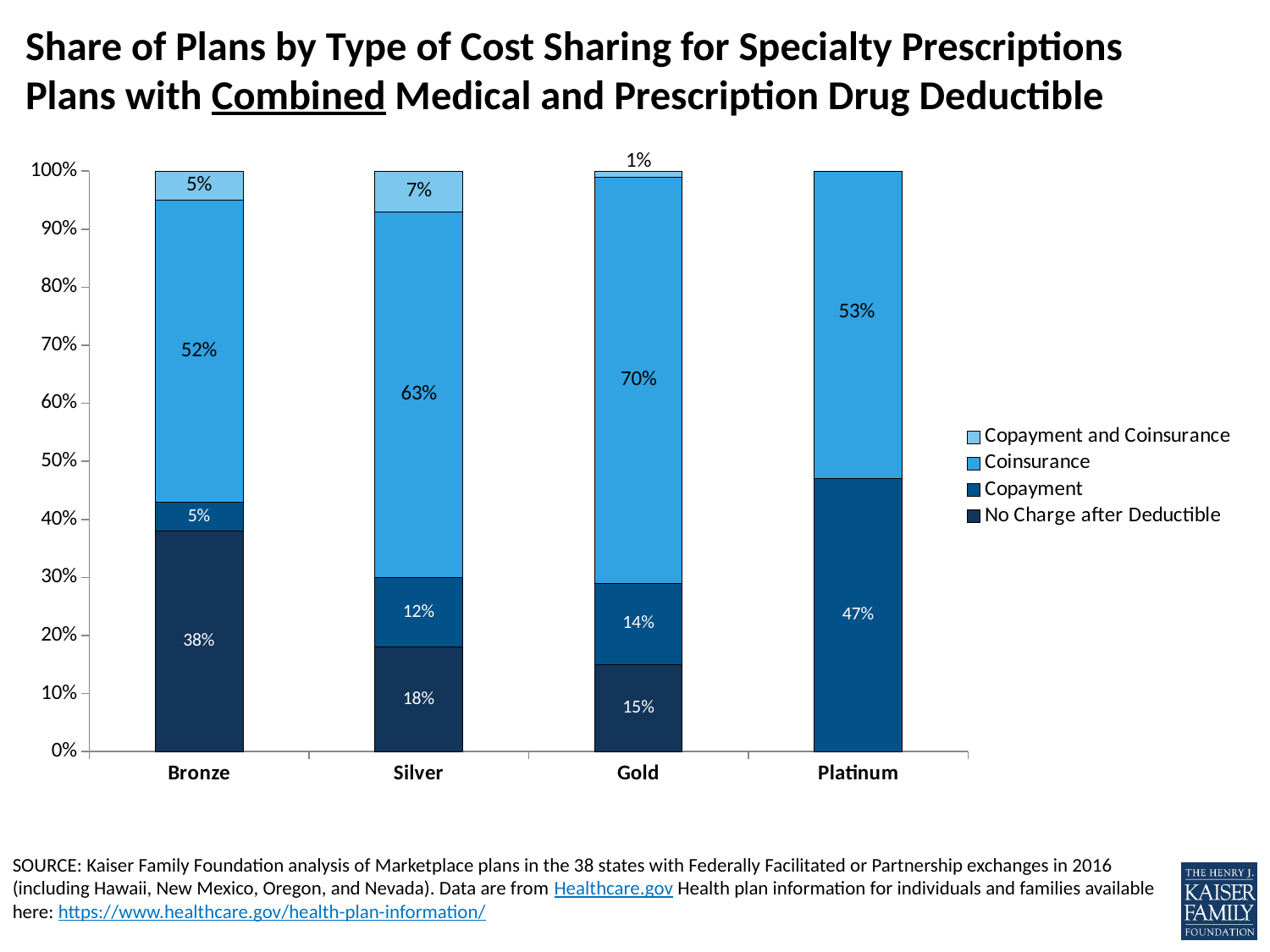
Which plan type has the highest Coinsurance share? Gold What is the No Charge after Deductible share for Bronze plans? 38% Which has a larger No Charge after Deductible share, Bronze or Silver? Bronze What is the Coinsurance share for Platinum plans? 53% What is the Copayment and Coinsurance share for Silver plans? 7% How many series does the legend list? 4 How many plan categories are shown on the x axis? 4 What is the difference between the Coinsurance share for Silver and for Bronze? 11 percentage points Which plan type has the lowest Copayment and Coinsurance share among those with a labeled value? Gold What is the Coinsurance share for Gold plans? 70% What kind of chart is shown on the slide? Stacked bar chart What is the Copayment share for Silver plans? 12%